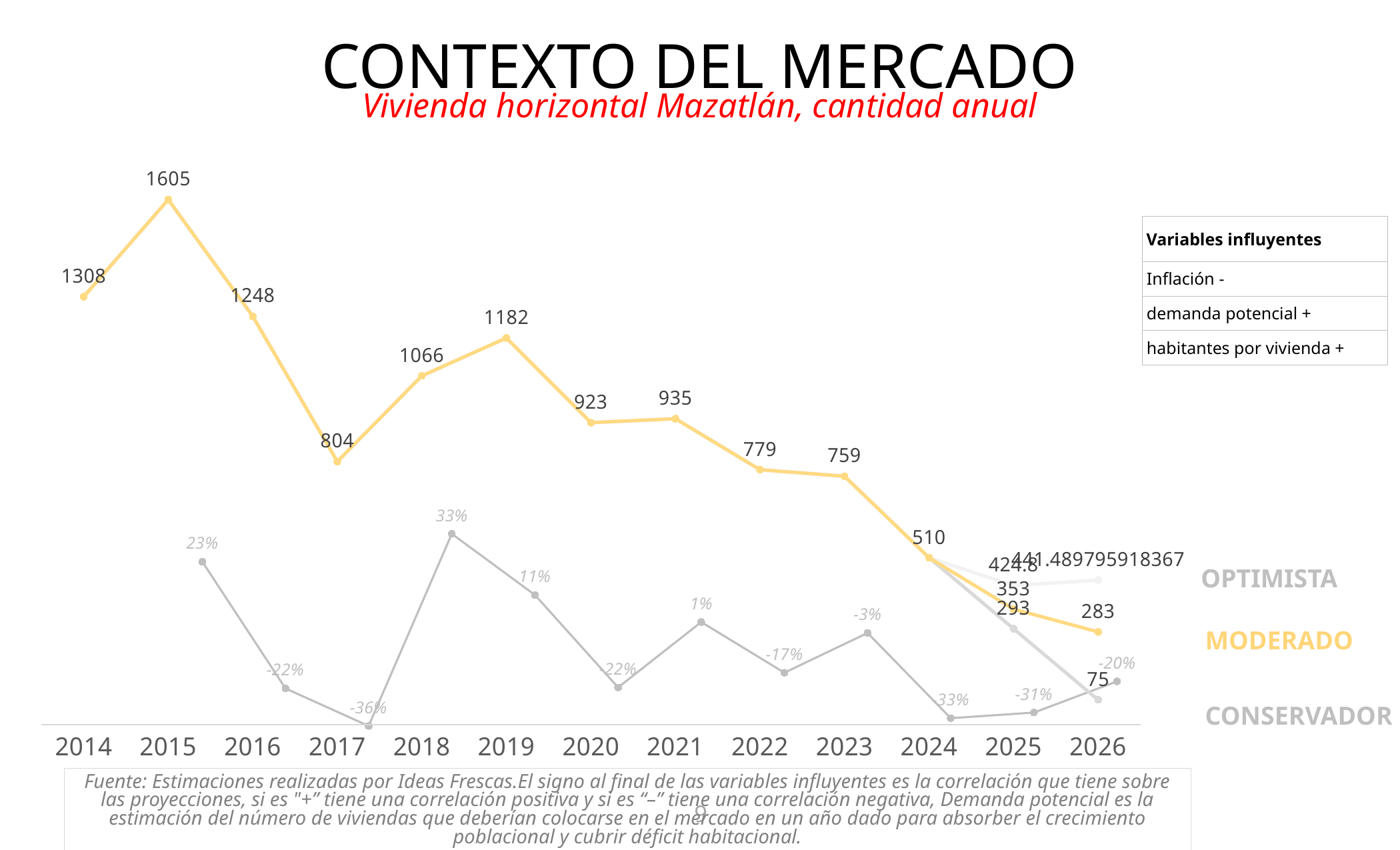
What type of chart is shown on the slide? line chart What is the value of the moderado (yellow) line in 2017? 804 What is the value of the moderado (yellow) line in 2026? 283 What is the difference between the moderado values for 2015 and 2016? 357 How many years are shown on the x axis? 13 What is the value of the optimista line in 2025? 424.8 What is the value of the conservador line in 2026? 75 In which year does the moderado (yellow) line reach its highest value? 2015 Which is larger, the moderado value for 2019 or for 2018? 2019 In which year does the moderado (yellow) line reach its lowest value? 2026 What is the red subtitle of the chart? Vivienda horizontal Mazatlán, cantidad anual What is the value of the moderado (yellow) line in 2015? 1605